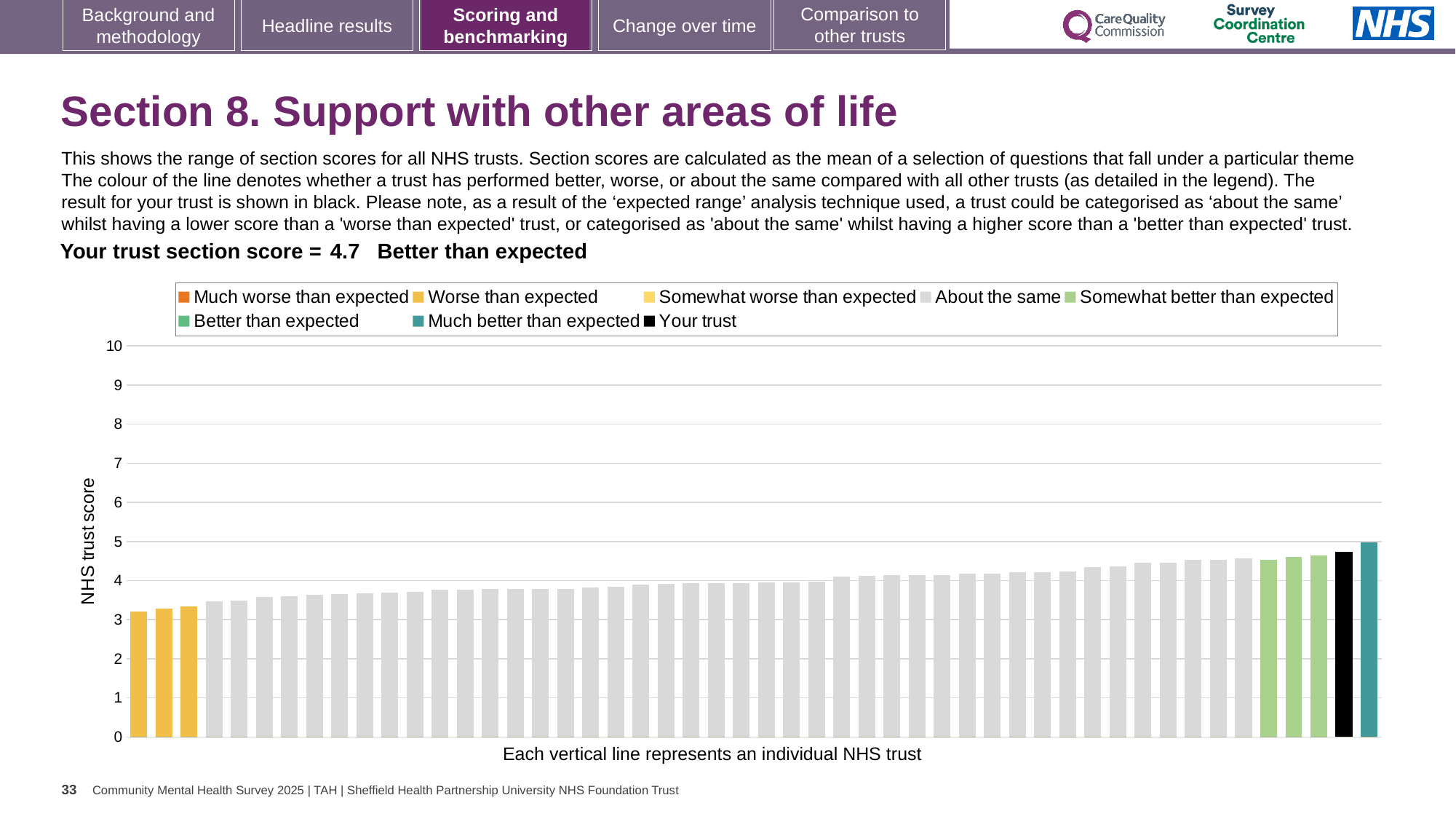
Which performance category is your trust placed in for this section? Better than expected Do the bar values rise or fall from left to right along the x axis? rise What kind of chart is shown on the slide? bar chart Which legend category do the lowest bars on the chart belong to? Worse than expected Is the value for your trust (the black bar) greater or less than 4? greater Is the value of the highest bar on the chart greater or less than 6? less What is the section score for your trust? 4.7 Is the value of the lowest bar on the chart greater or less than 4? less How many entries does the chart legend list? 8 Which legend category does the highest bar on the chart belong to? Much better than expected What is the label on the y axis of the chart? NHS trust score How many bars are coloured as 'Worse than expected'? 3